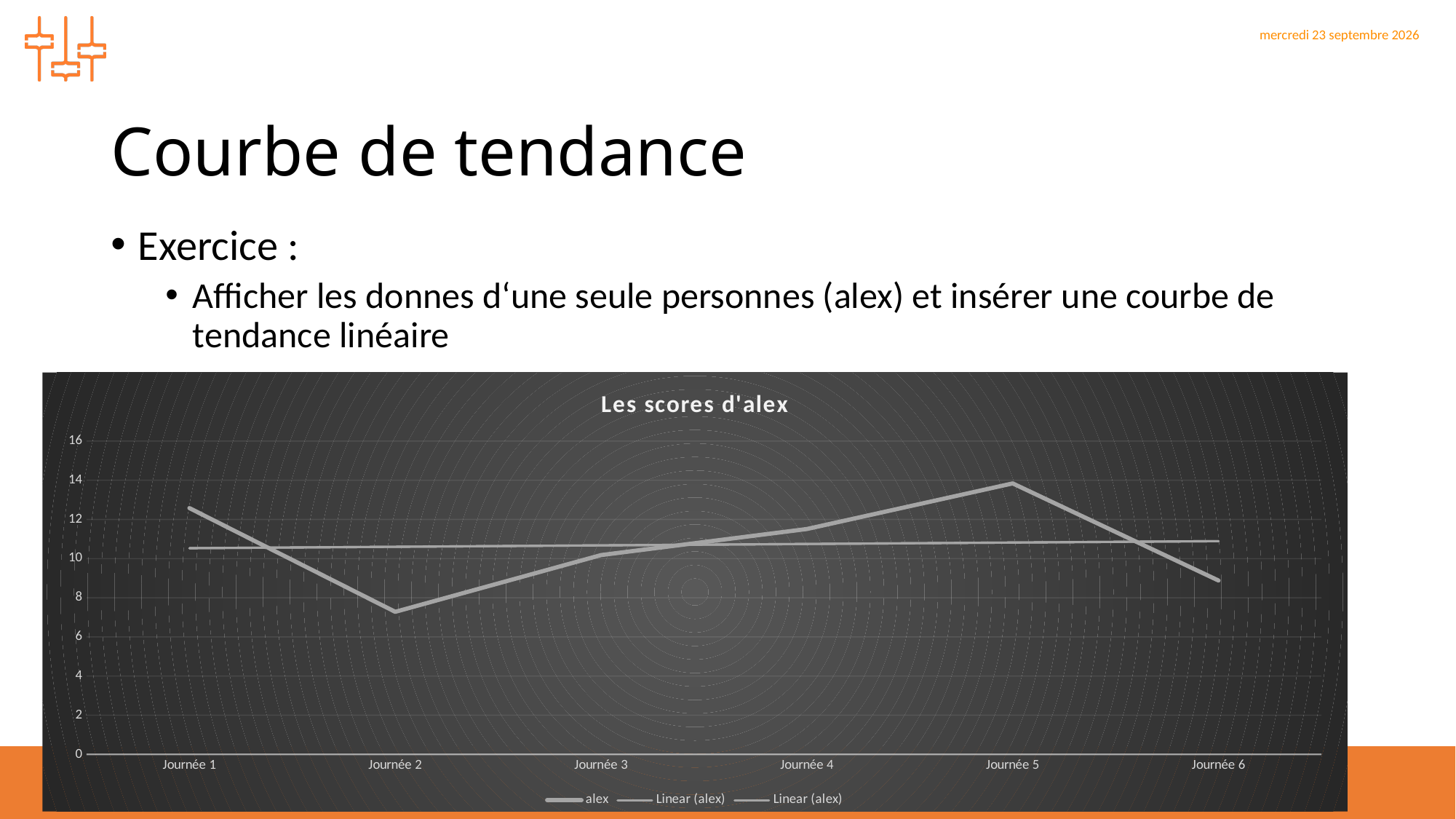
Which is larger, alex's score for Journée 1 or for Journée 2? Journée 1 On which journée is alex's score the lowest? Journée 2 How many categories (journées) are shown on the x axis? 6 Is alex's score for Journée 5 greater or less than 12? greater Is alex's score for Journée 6 greater or less than 10? less On which journée is alex's score the highest? Journée 5 How many entries does the chart legend list? 3 What is the title of the chart? Les scores d'alex Which is larger, alex's score for Journée 5 or for Journée 6? Journée 5 Does alex's score rise or fall from Journée 2 to Journée 5? rise What kind of chart is shown on the slide? line chart Is alex's score for Journée 2 greater or less than 8? less